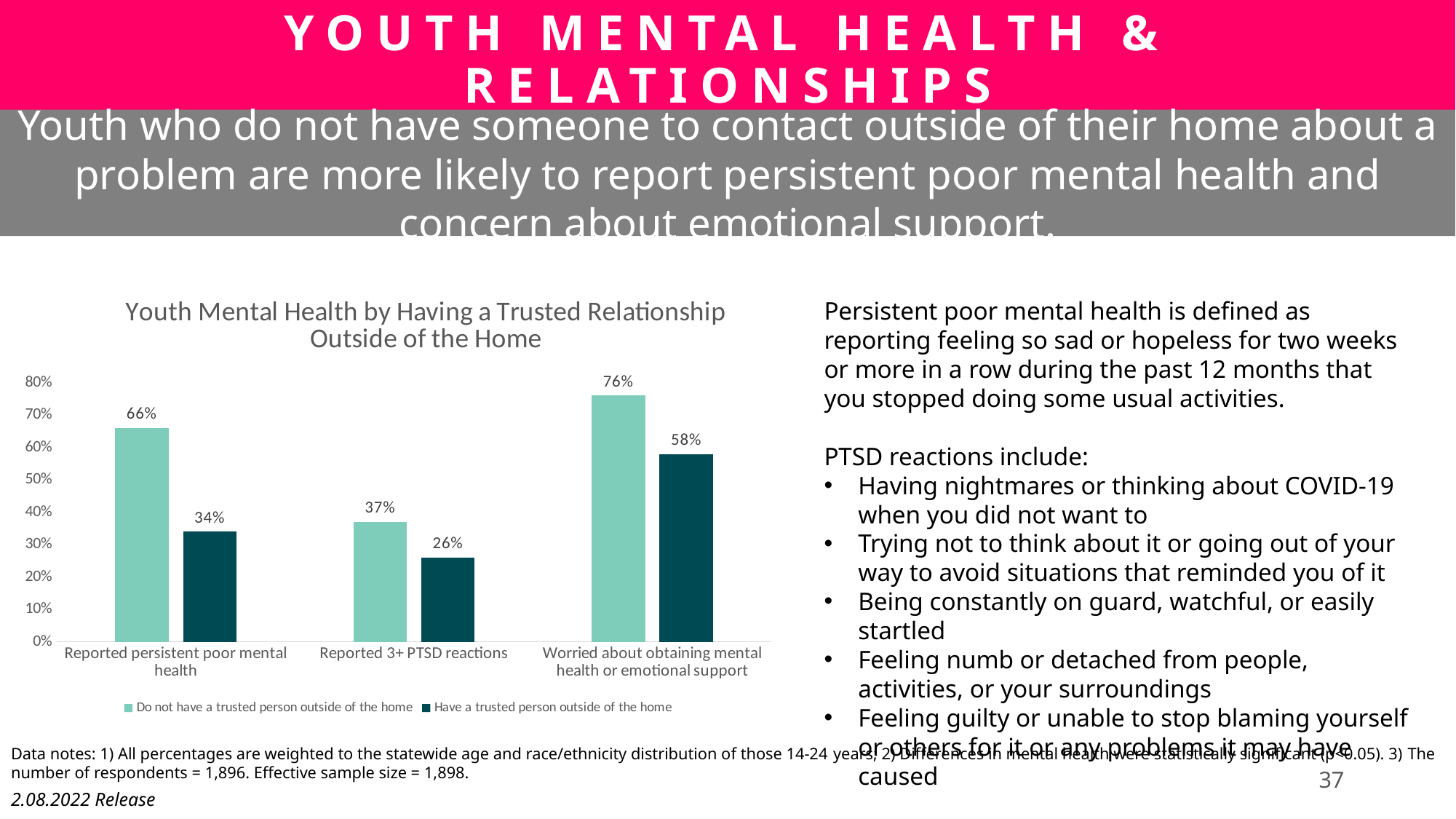
What percentage of youth who have a trusted person outside of the home reported 3+ PTSD reactions? 26% Which category has the highest value for youth who have a trusted person outside of the home? Worried about obtaining mental health or emotional support Which category has the lowest value for youth who do not have a trusted person outside of the home? Reported 3+ PTSD reactions What type of chart is shown on the slide? Bar chart What is the title of the chart? Youth Mental Health by Having a Trusted Relationship Outside of the Home For 'Reported 3+ PTSD reactions', which group has the larger value: those who do not have a trusted person outside of the home or those who have one? Do not have a trusted person outside of the home How many series does the chart legend list? 2 What percentage of youth who do not have a trusted person outside of the home were worried about obtaining mental health or emotional support? 76% How many categories are shown on the x axis of the chart? 3 What is the difference between the two groups for 'Worried about obtaining mental health or emotional support'? 18% What percentage of youth who do not have a trusted person outside of the home reported persistent poor mental health? 66% What is the difference between the two groups for 'Reported persistent poor mental health'? 32%